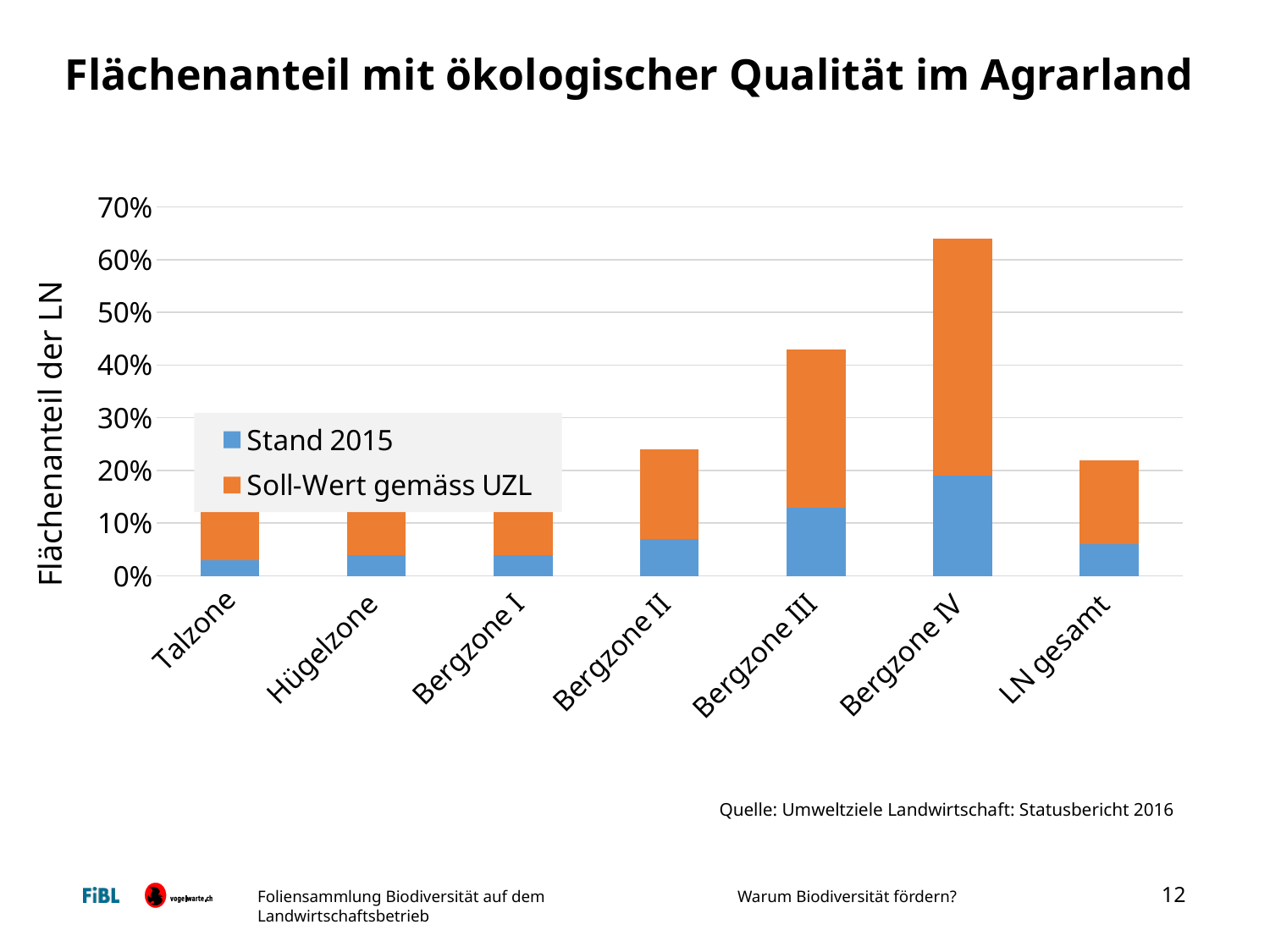
Which category has the highest value for Stand 2015? Bergzone IV Do the total bars rise or fall from Talzone to Bergzone IV? rise How many categories are shown on the x axis of the chart? 7 How many series does the chart legend list? 2 Is the total bar for Bergzone IV greater or less than 60%? greater What is the title of the chart on the slide? Flächenanteil mit ökologischer Qualität im Agrarland Is the total bar for Bergzone III greater or less than 40%? greater Which has the larger total bar, Bergzone II or Bergzone III? Bergzone III Which category has the highest total bar in the chart? Bergzone IV What kind of chart is shown on the slide? stacked bar chart Is the total bar for Talzone greater or less than 20%? less